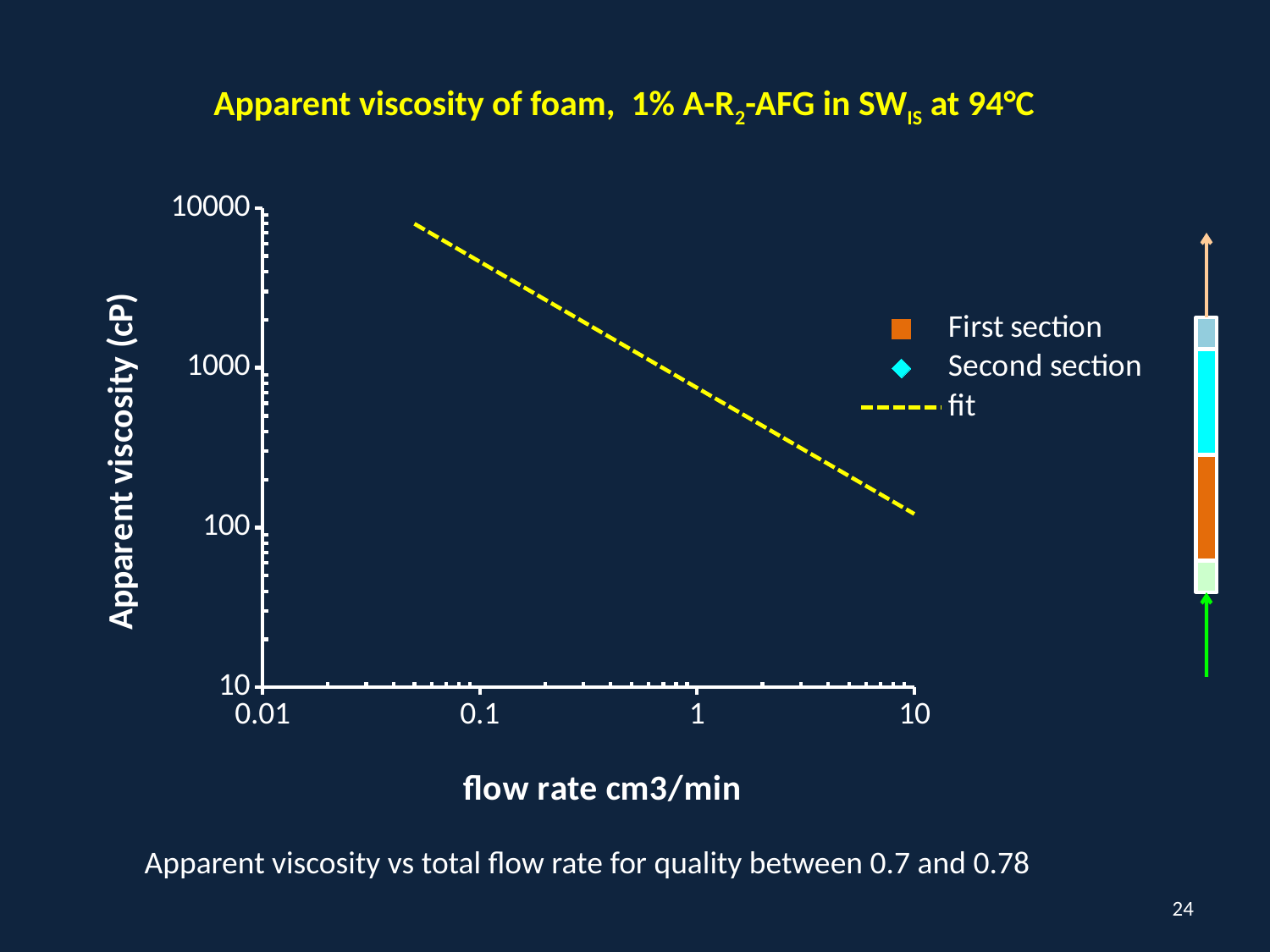
Is the fit line's apparent viscosity at a flow rate of 0.1 cm3/min greater or less than 1000 cP? greater How many series does the legend list? 3 Which is higher on the fit line: the apparent viscosity at a flow rate of 0.1 cm3/min or at 1 cm3/min? 0.1 cm3/min What is the label of the x axis? flow rate cm3/min Does the fit line rise or fall as flow rate increases along the x axis? fall Is the fit line's apparent viscosity at a flow rate of 1 cm3/min greater or less than 1000 cP? less Is the fit line's apparent viscosity at a flow rate of 1 cm3/min greater or less than 100 cP? greater What kind of chart is shown on the slide? line chart What is the label of the y axis? Apparent viscosity (cP)